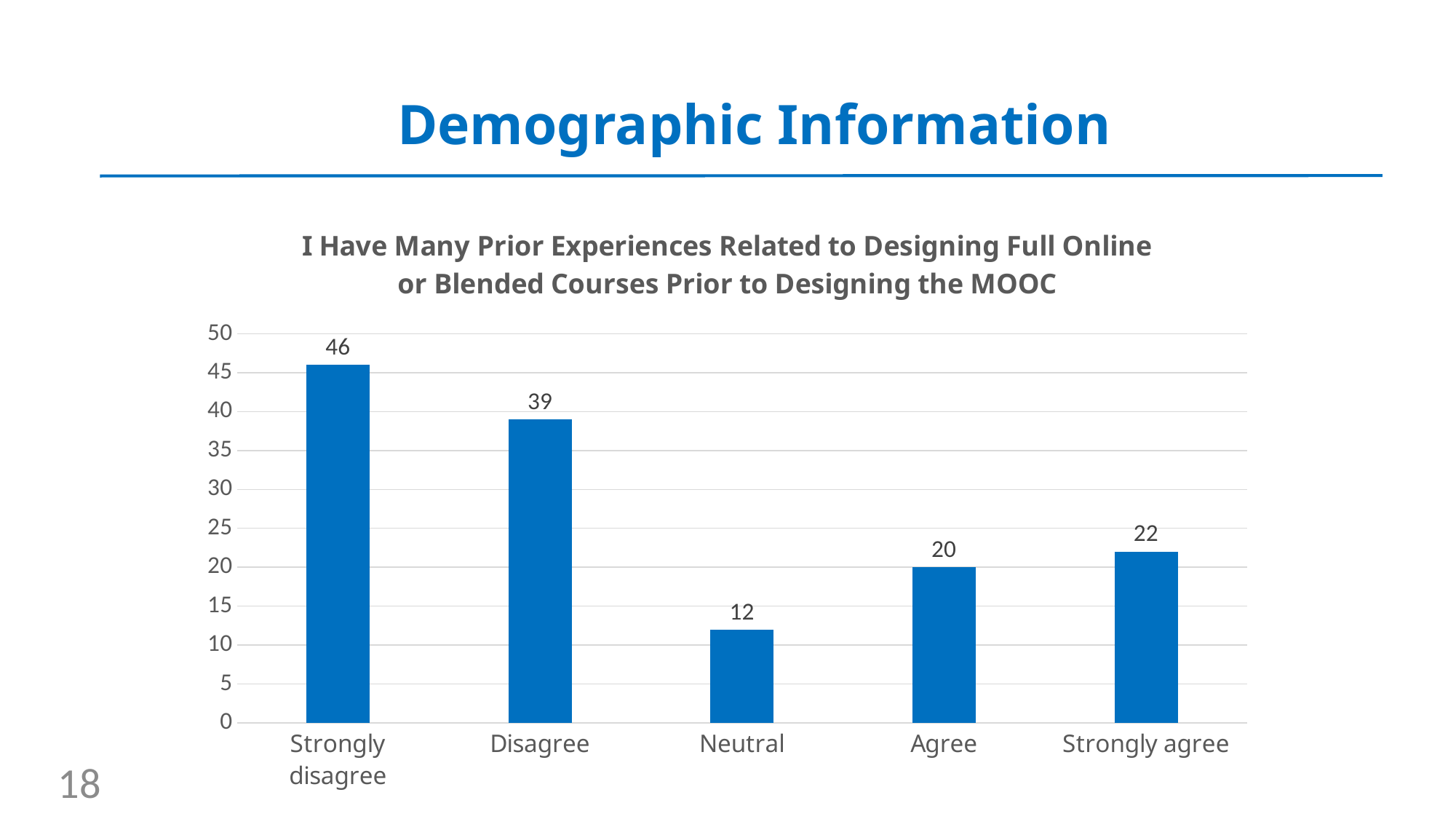
What is the difference between the values for Strongly agree and Agree? 2 Which is larger, the value for Agree or the value for Disagree? Disagree Which category has the highest value? Strongly disagree Which category has the lowest value? Neutral What kind of chart is shown on the slide? Bar chart What is the title of the chart? I Have Many Prior Experiences Related to Designing Full Online or Blended Courses Prior to Designing the MOOC How many categories are shown on the x axis? 5 What is the value for Neutral? 12 What is the value for Strongly disagree? 46 What is the difference between the values for Strongly disagree and Disagree? 7 What is the value for Strongly agree? 22 Is the value for Disagree greater or less than 35? greater